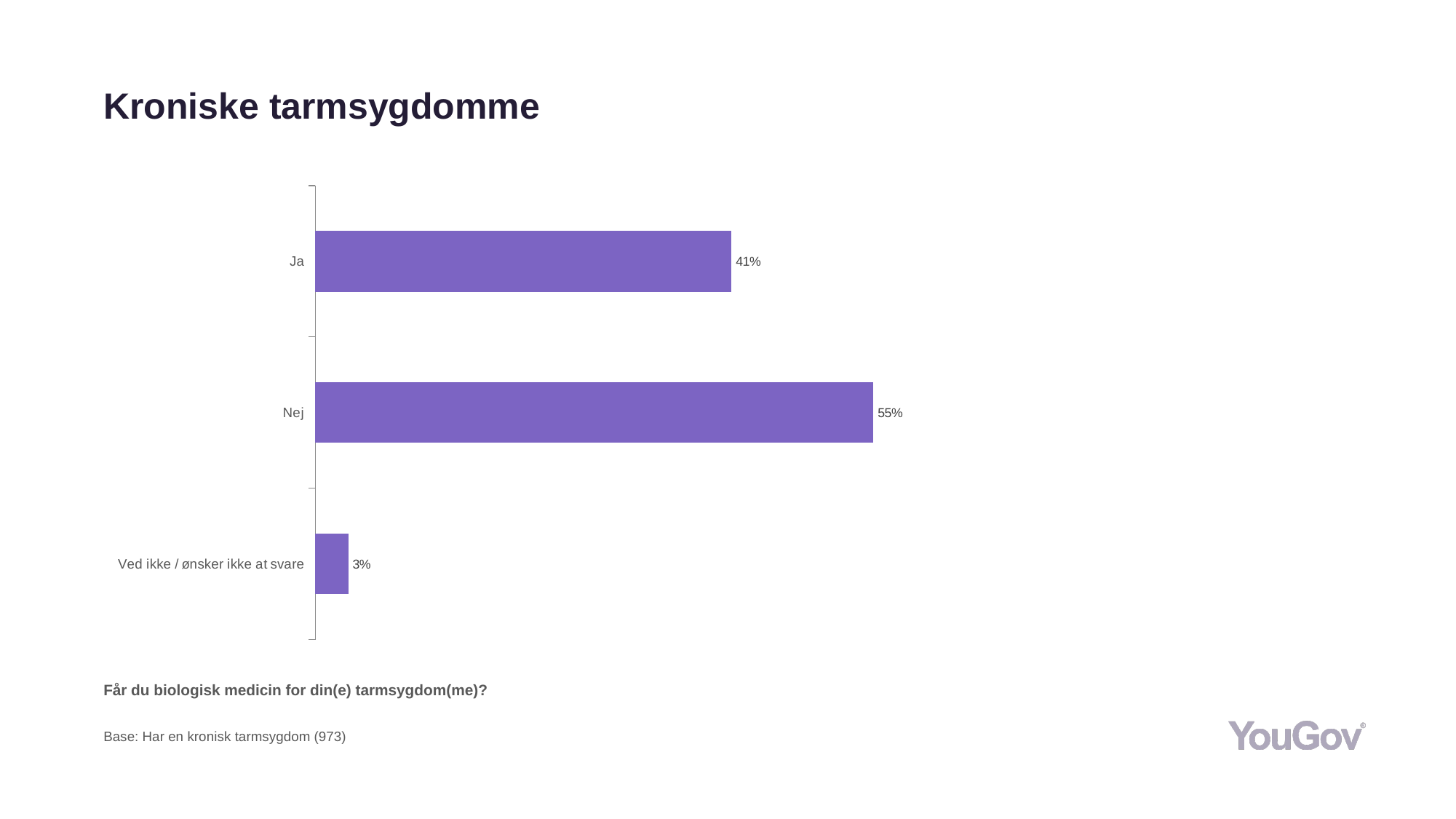
What is the difference between the values for "Nej" and "Ja"? 14 percentage points What kind of chart is shown on the slide? Bar chart What is the value for "Ved ikke / ønsker ikke at svare"? 3% Which category has the lowest value? Ved ikke / ønsker ikke at svare What is the base size stated below the chart? 973 What is the difference between the values for "Ja" and "Ved ikke / ønsker ikke at svare"? 38 percentage points What is the value for "Ja"? 41% How many categories are shown in the chart? 3 What is the title of the slide? Kroniske tarmsygdomme Which category has the highest value? Nej What is the value for "Nej"? 55% Which is larger, the value for "Ja" or the value for "Nej"? Nej